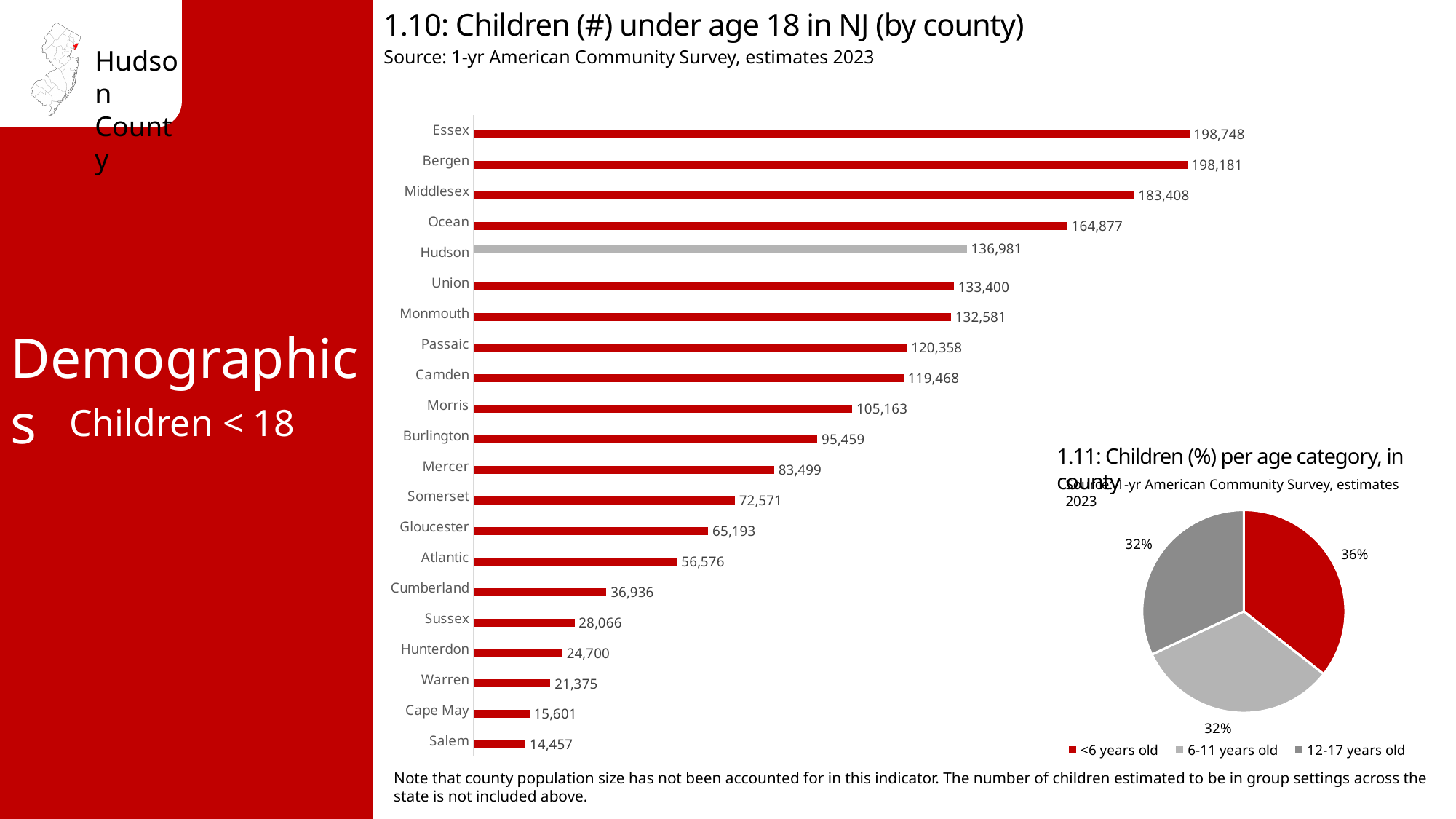
In chart 1.10, what is the difference between the values for Hudson and Union? 3,581 In chart 1.11, what share of children are under 6 years old? 36% In chart 1.10, which county's bar is shown in grey rather than red? Hudson In chart 1.10, how many counties are shown? 21 In chart 1.10, which county has the lowest number of children under age 18? Salem In chart 1.10, what is the difference between the values for Essex and Bergen? 567 In chart 1.10, which county has the highest number of children under age 18? Essex In chart 1.10, what is the value for Ocean County? 164,877 In chart 1.10, how many children under age 18 are in Hudson County? 136,981 In chart 1.11, how many age categories does the legend list? 3 What kind of chart is chart 1.10? Bar chart In chart 1.10, which has more children under 18, Passaic or Camden? Passaic